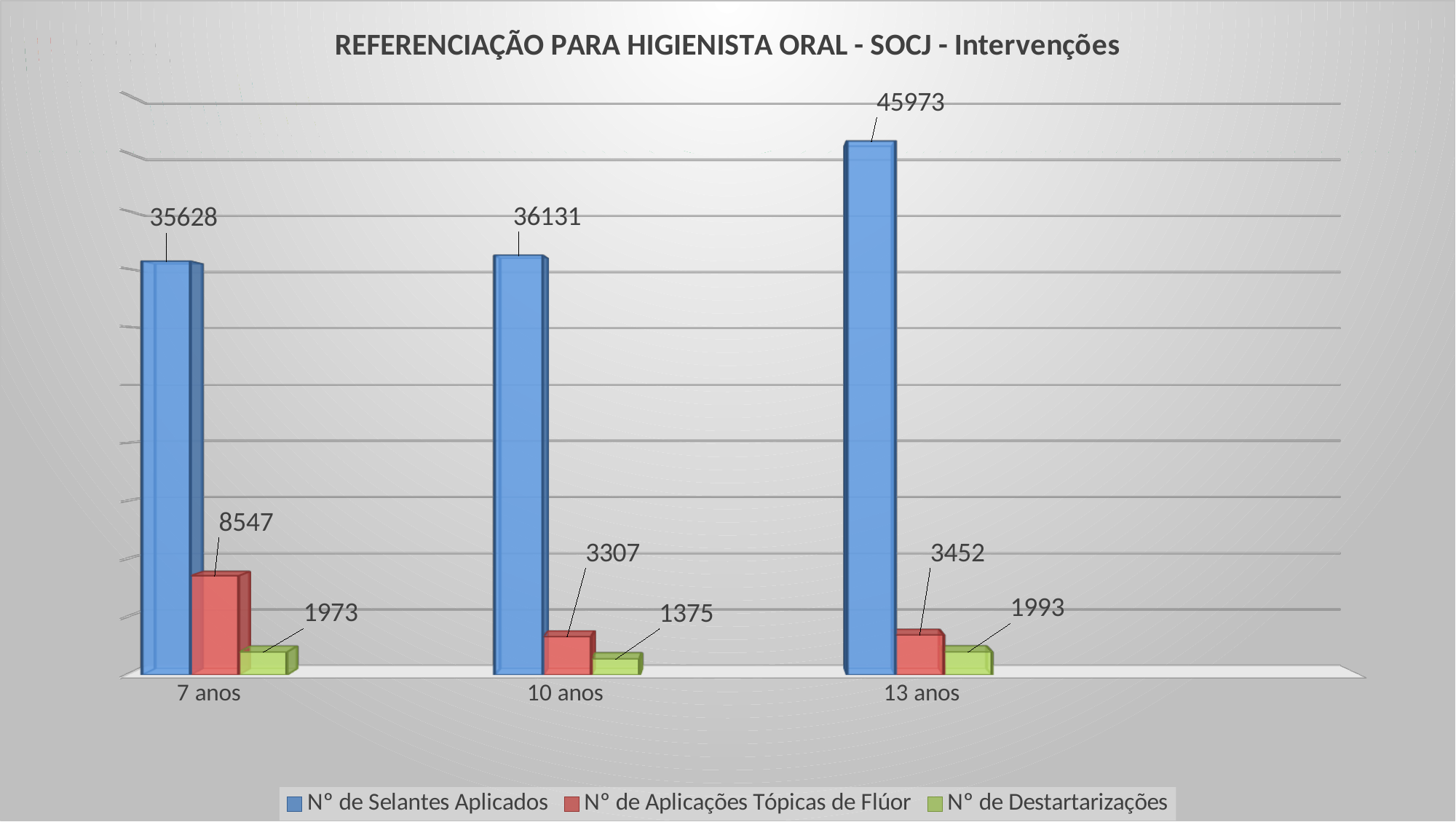
What is the value of Nº de Selantes Aplicados for 10 anos? 36131 Which age group has the lowest value for Nº de Destartarizações? 10 anos What is the value of Nº de Destartarizações for 10 anos? 1375 How many age groups are shown on the x axis? 3 What is the value of Nº de Aplicações Tópicas de Flúor for 7 anos? 8547 Which age group has the highest value for Nº de Selantes Aplicados? 13 anos What is the title of the chart? REFERENCIAÇÃO PARA HIGIENISTA ORAL - SOCJ - Intervenções What is the difference between Nº de Selantes Aplicados for 13 anos and for 7 anos? 10345 How many series does the legend list? 3 What is the value of Nº de Selantes Aplicados for 13 anos? 45973 Which is larger: Nº de Aplicações Tópicas de Flúor for 10 anos or for 13 anos? 13 anos What kind of chart is shown on the slide? Bar chart